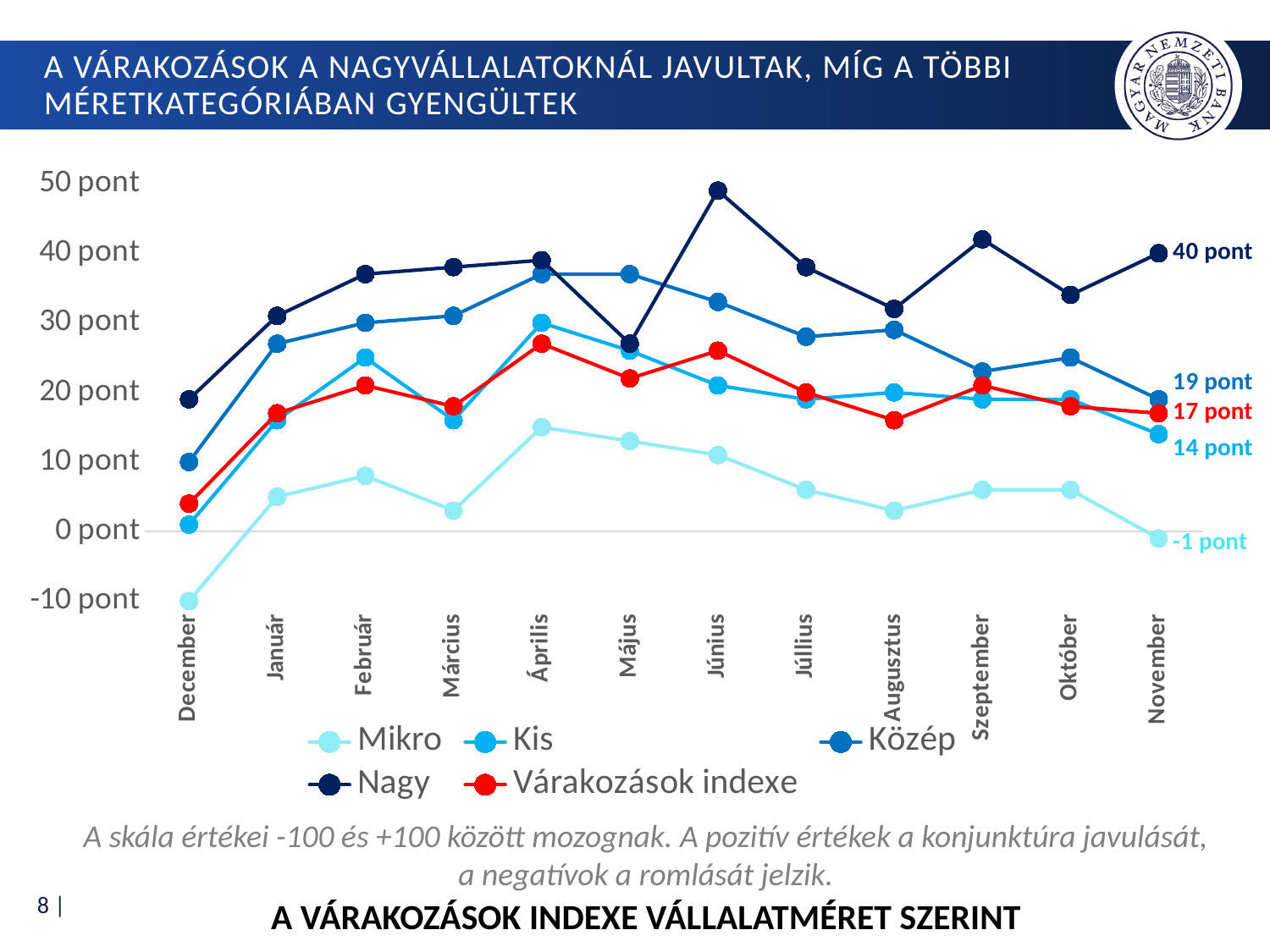
Which series has the lowest value in November? Mikro Which series has the highest value in November? Nagy What kind of chart is shown on the slide? line chart How many series does the legend list? 5 What is the value of the Nagy series in November? 40 pont How many months are shown on the x axis? 12 Is the value for Mikro in December greater or less than 0 pont? less What is the value of the Közép series in November? 19 pont What is the value of the Mikro series in November? -1 pont What is the difference between the Nagy and Közép values in November? 21 pont Is the value for Nagy in Június greater or less than 40 pont? greater What is the value of the Várakozások indexe series in November? 17 pont